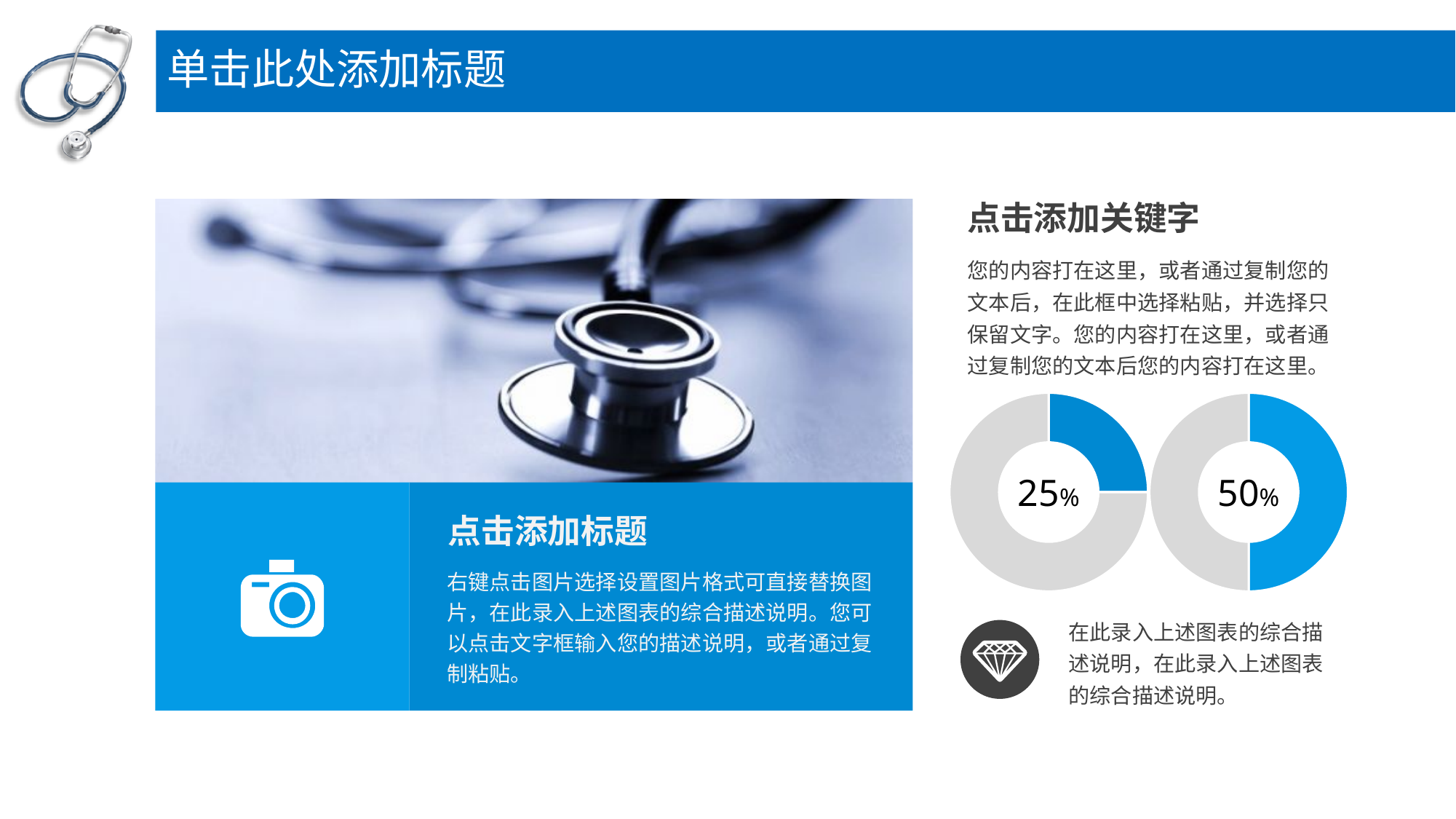
What is the difference between the value in the right doughnut chart and the value in the left doughnut chart? 25% What colour is the unfilled remainder of each doughnut chart? grey What colour is used for the filled portion of both doughnut charts? blue What kind of chart is used to display the 25% and 50% values? doughnut chart What share of the right doughnut chart is filled in blue? 50% Which doughnut chart shows the larger value, the left one or the right one? the right one How many doughnut charts are shown on the slide? 2 What share of the left doughnut chart is filled in blue? 25% What value is shown in the centre of the right doughnut chart? 50% What value is shown in the centre of the left doughnut chart? 25% Is the value shown in the left doughnut chart greater or less than 50%? less